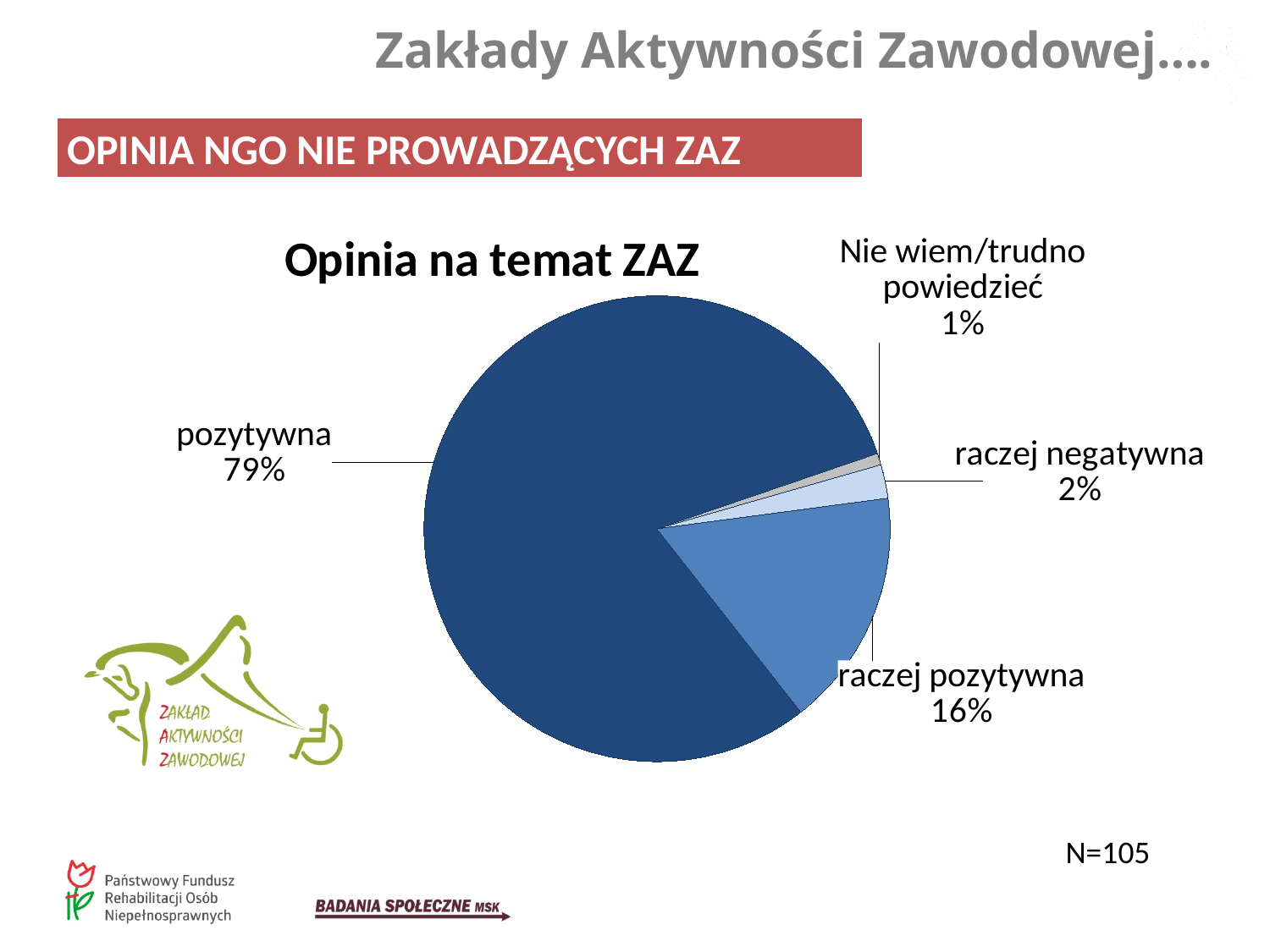
What type of chart is shown on the slide? pie chart What is the title of the chart? Opinia na temat ZAZ What percentage of respondents gave the opinion 'raczej negatywna'? 2% What percentage of respondents gave the opinion 'pozytywna'? 79% How many categories are shown in the pie chart? 4 Which category has the smallest share of the pie? Nie wiem/trudno powiedzieć Which is larger: the share for 'raczej pozytywna' or for 'raczej negatywna'? raczej pozytywna What is the sample size (N) stated on the slide? N=105 What percentage of respondents answered 'Nie wiem/trudno powiedzieć'? 1% What percentage of respondents gave the opinion 'raczej pozytywna'? 16% Which category has the largest share of the pie? pozytywna What is the difference in percentage points between 'pozytywna' and 'raczej pozytywna'? 63